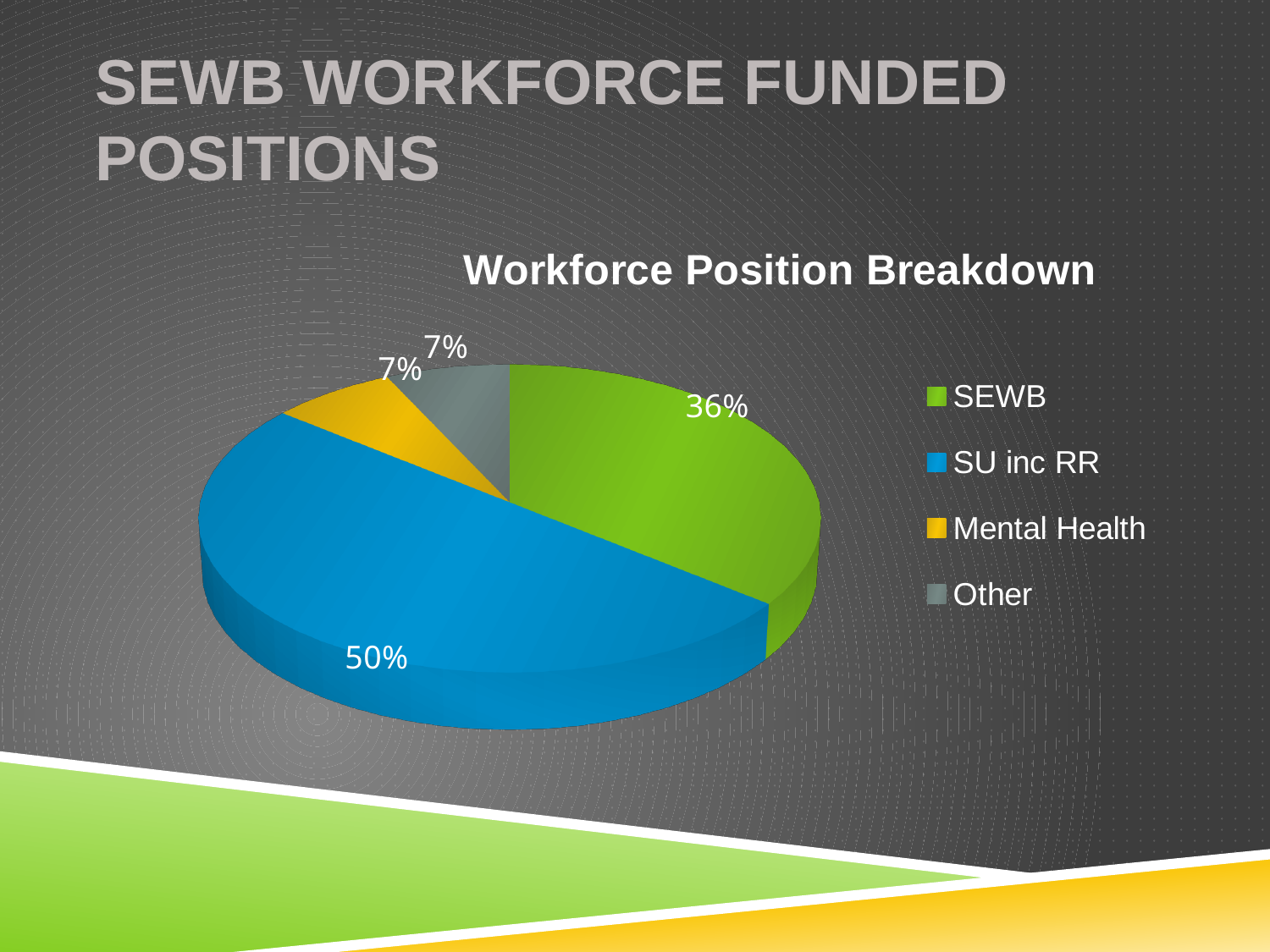
What share of the pie does Other represent? 7% Which is larger, the share for SEWB or the share for Mental Health? SEWB What share of the pie does SEWB represent? 36% What share of the pie does SU inc RR represent? 50% What is the title of the chart? Workforce Position Breakdown What type of chart is shown on the slide? Pie chart How many categories does the pie chart show? 4 What colour represents SU inc RR in the chart? Blue What is the difference between the SU inc RR share and the SEWB share? 14% What is the combined share of Mental Health and Other? 14% Which category has the largest share of the pie? SU inc RR